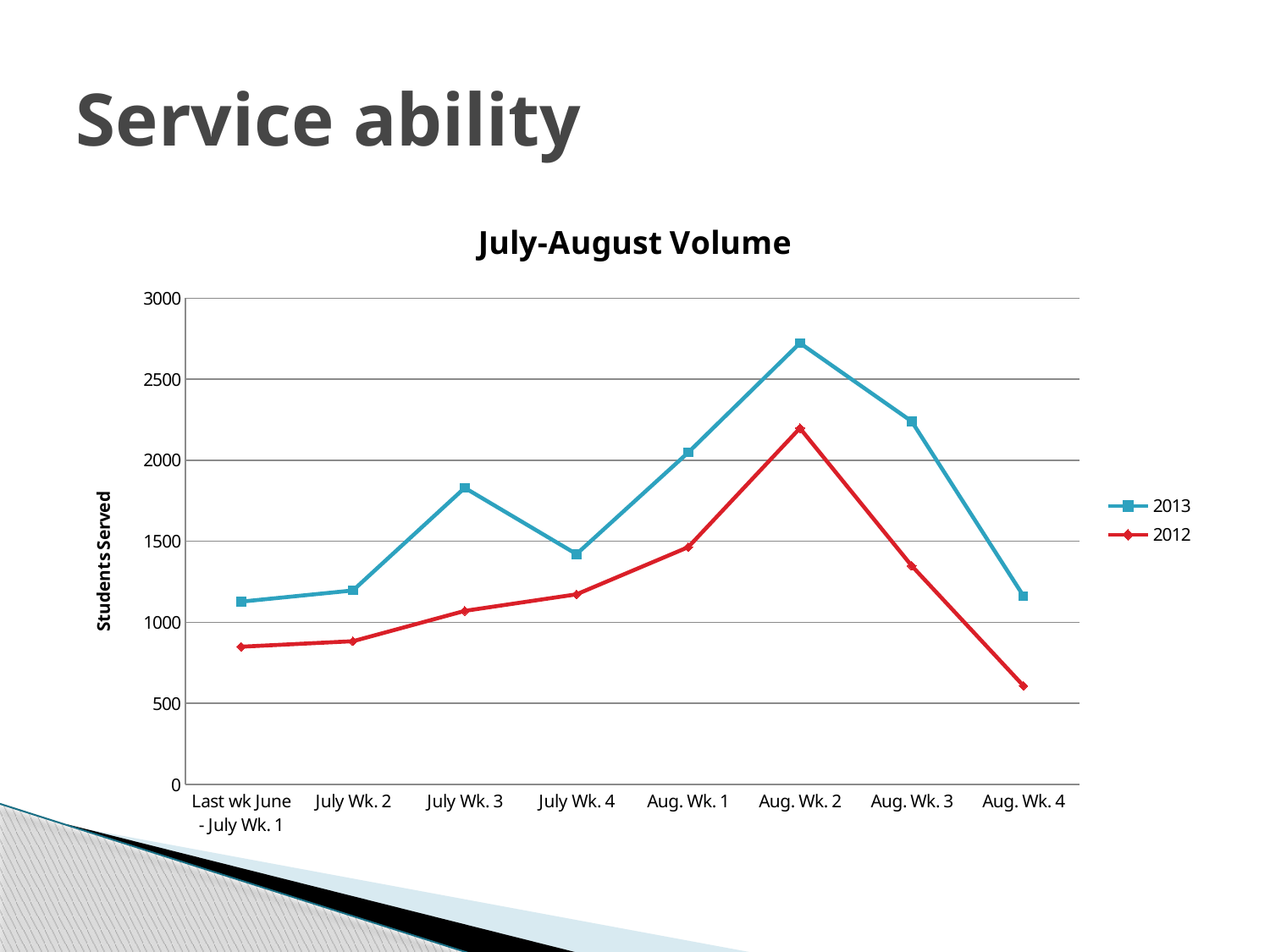
What is the label on the vertical axis of the July-August Volume chart? Students Served How many weekly categories are plotted along the x axis of the July-August Volume chart? 8 Is the 2013 value for July Wk. 3 greater or less than 1500? greater Does the 2012 series rise or fall from Aug. Wk. 2 to Aug. Wk. 4? fall In which week does the 2012 series reach its lowest value? Aug. Wk. 4 How many series does the legend list in the July-August Volume chart? 2 For Aug. Wk. 3, which series has the larger value, 2013 or 2012? 2013 What kind of chart is shown under the title "July-August Volume"? line chart In which week does the 2013 series reach its highest value? Aug. Wk. 2 Is the 2013 value for Aug. Wk. 2 greater or less than 2500? greater Is the 2012 value for Aug. Wk. 4 greater or less than 1000? less